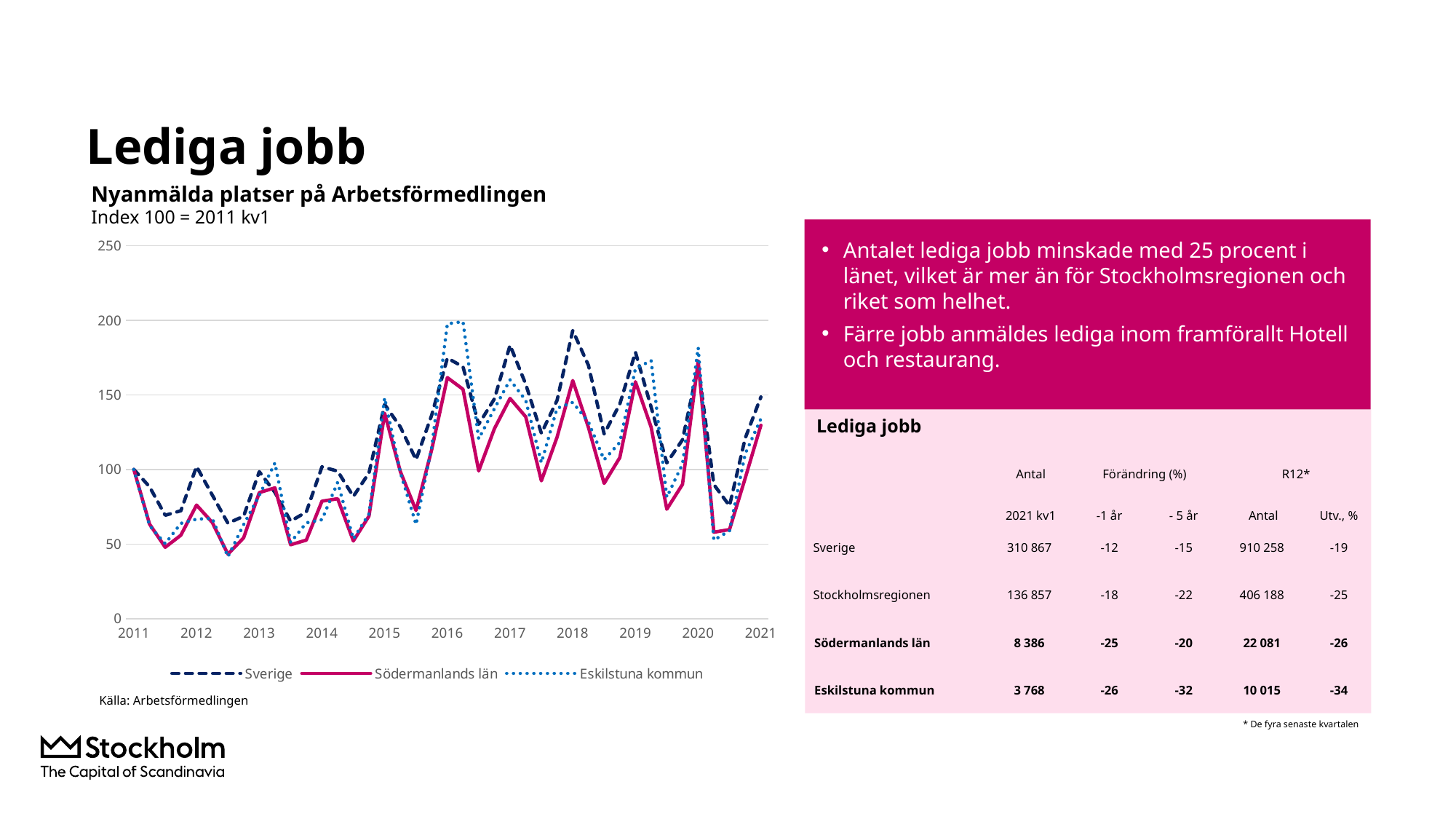
What is the title of the chart? Nyanmälda platser på Arbetsförmedlingen Which series are listed in the chart legend? Sverige, Södermanlands län, Eskilstuna kommun How many year labels are shown on the x axis? 11 How many series does the chart legend list? 3 What is the index value for all three series at 2011 kv1? 100 Is the peak value for Eskilstuna kommun in 2016 greater or less than 150? greater Is the lowest value for Södermanlands län in 2020 greater or less than 100? less Which series reaches the highest point on the chart? Eskilstuna kommun At the 2016 peak, which series is higher: Eskilstuna kommun or Södermanlands län? Eskilstuna kommun Is the peak value for Sverige in 2018 greater or less than 150? greater Do the values for Södermanlands län generally rise or fall from 2011 to 2016? rise What kind of chart is shown on the slide? line chart